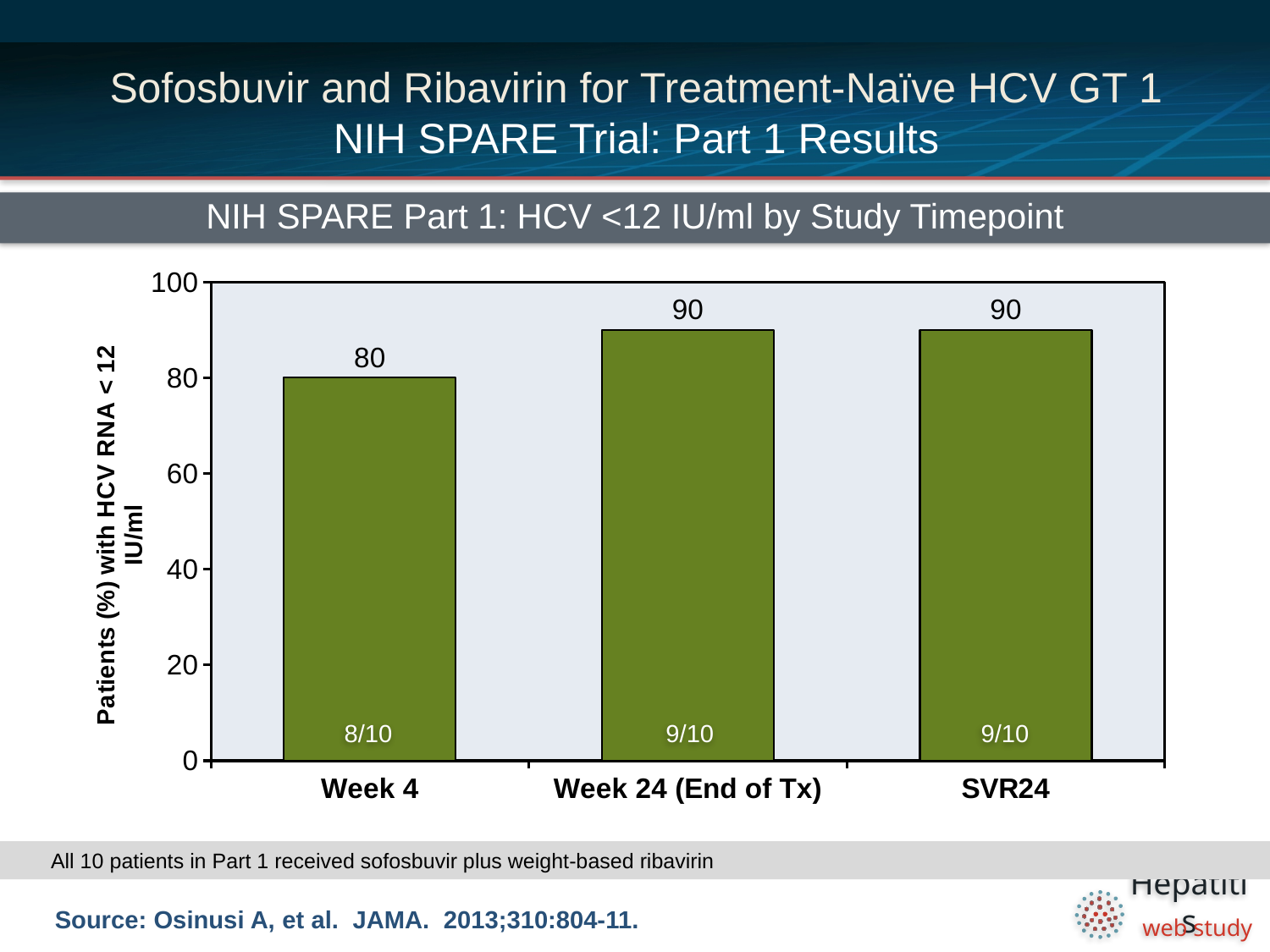
What is the value for Week 24 (End of Tx)? 90 Is the value for Week 4 greater or less than 60? greater What fraction of patients is printed inside the Week 4 bar? 8/10 Which is larger, the value for Week 4 or the value for SVR24? SVR24 What is the title of the chart? NIH SPARE Part 1: HCV <12 IU/ml by Study Timepoint What is the value for Week 4? 80 What is the value for SVR24? 90 Which timepoint has the lowest value? Week 4 How many timepoints are shown on the x axis? 3 What is the difference between the values for Week 24 (End of Tx) and Week 4? 10 Do the values rise or fall from Week 4 to Week 24 (End of Tx)? Rise What kind of chart is shown? Bar chart